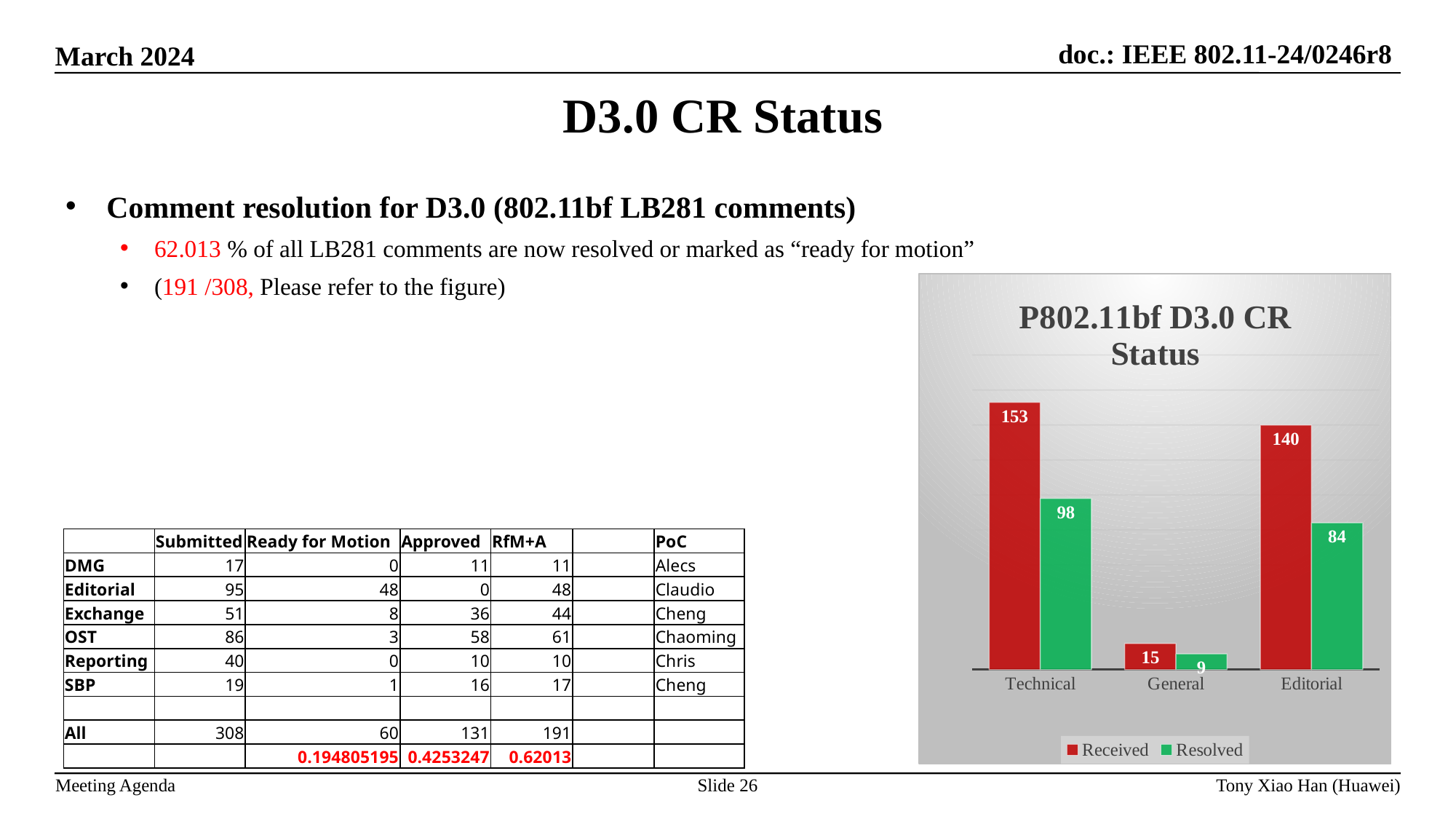
What is the Resolved value for General in the P802.11bf D3.0 CR Status chart? 9 What type of chart is the P802.11bf D3.0 CR Status chart? bar chart What is the Received value for Editorial in the P802.11bf D3.0 CR Status chart? 140 What is the Received value for Technical in the P802.11bf D3.0 CR Status chart? 153 Which category has the highest Received value in the P802.11bf D3.0 CR Status chart? Technical Is the Resolved value for Technical larger or smaller than the Resolved value for Editorial in the P802.11bf D3.0 CR Status chart? larger Which category has the lowest Resolved value in the P802.11bf D3.0 CR Status chart? General What is the difference between Received and Resolved for Technical in the P802.11bf D3.0 CR Status chart? 55 What is the difference between Received and Resolved for Editorial in the P802.11bf D3.0 CR Status chart? 56 How many series does the legend of the P802.11bf D3.0 CR Status chart list? 2 What is the Resolved value for Editorial in the P802.11bf D3.0 CR Status chart? 84 How many categories are shown on the x axis of the P802.11bf D3.0 CR Status chart? 3